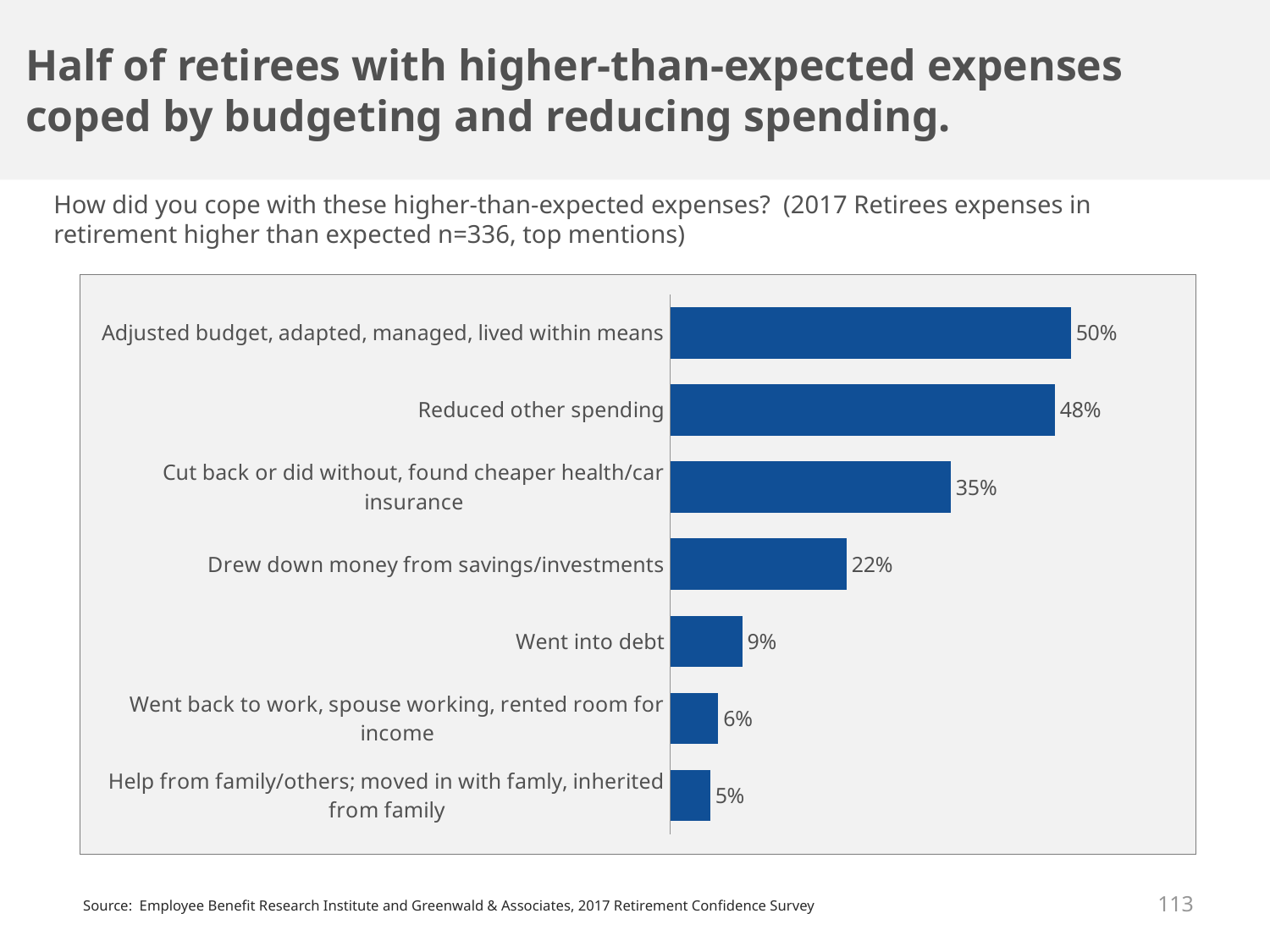
What is the sample size (n) stated in the chart's question text? n=336 What is the difference between 'Cut back or did without, found cheaper health/car insurance' and 'Drew down money from savings/investments'? 13 percentage points Which coping method has the highest percentage in the chart? Adjusted budget, adapted, managed, lived within means Which coping method has the lowest percentage in the chart? Help from family/others; moved in with famly, inherited from family What percentage of retirees reported 'Reduced other spending' as a way they coped with higher-than-expected expenses? 48% What percentage is shown for 'Went into debt'? 9% How many coping methods (categories) are shown in the chart? 7 Which is larger: the value for 'Went into debt' or the value for 'Went back to work, spouse working, rented room for income'? Went into debt What is the difference in percentage points between 'Adjusted budget, adapted, managed, lived within means' and 'Reduced other spending'? 2 percentage points What type of chart is shown on the slide? Bar chart Do the values increase or decrease going from the top bar to the bottom bar? Decrease What is the value shown for 'Drew down money from savings/investments'? 22%